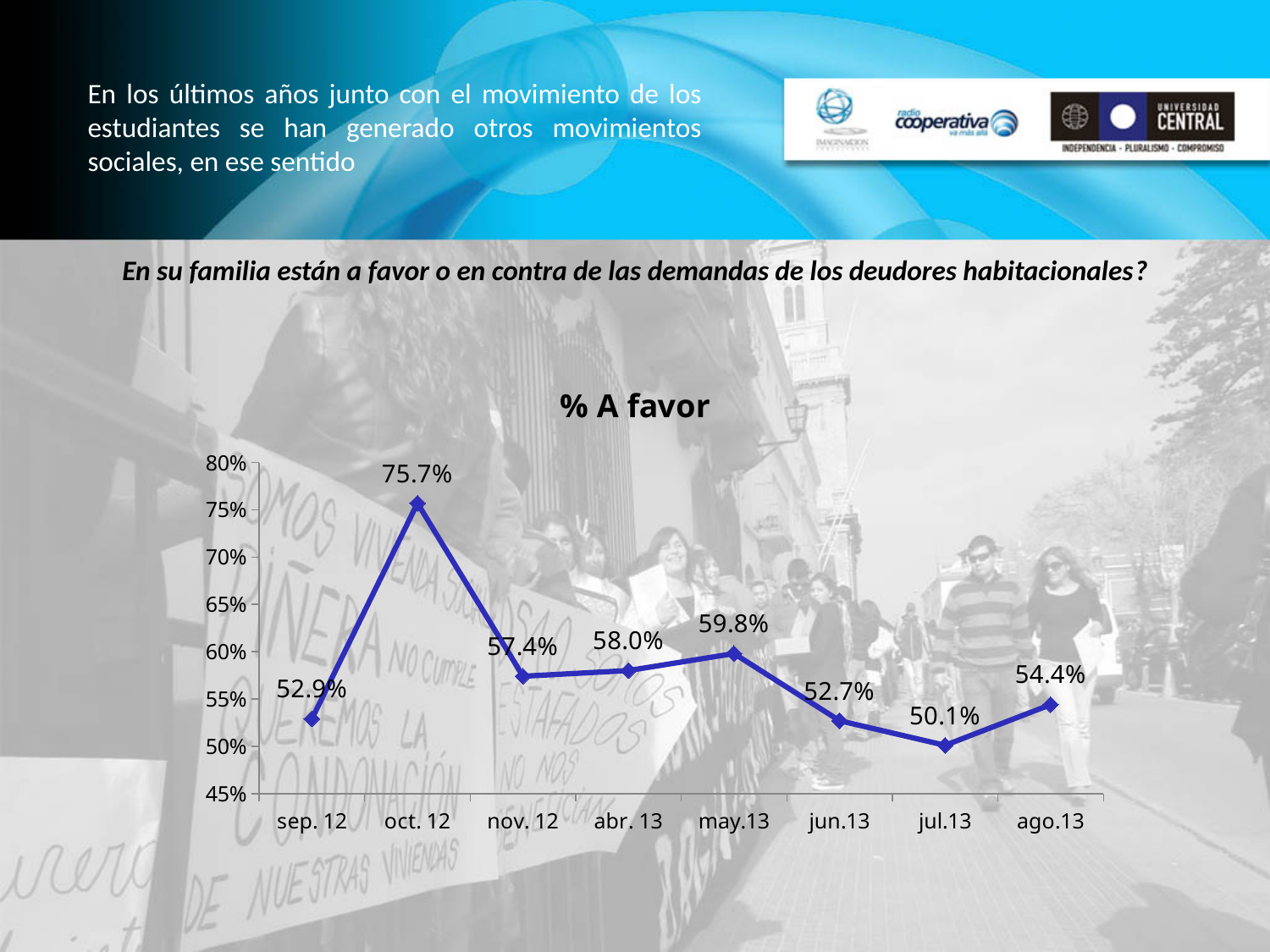
Does the value in the '% A favor' chart rise or fall from may.13 to jul.13? fall Which month has the highest value in the '% A favor' chart? oct. 12 Is the value for jun.13 in the '% A favor' chart greater or less than 55%? less What is the value for may.13 in the '% A favor' chart? 59.8% Which is larger in the '% A favor' chart, the value for sep. 12 or the value for ago.13? ago.13 What is the value for oct. 12 in the '% A favor' chart? 75.7% How many data points are plotted in the '% A favor' chart? 8 What is the difference between the values for ago.13 and jul.13 in the '% A favor' chart? 4.3% What kind of chart is the '% A favor' chart? line chart Which month has the lowest value in the '% A favor' chart? jul.13 What is the value for jul.13 in the '% A favor' chart? 50.1% What is the difference between the values for oct. 12 and nov. 12 in the '% A favor' chart? 18.3%